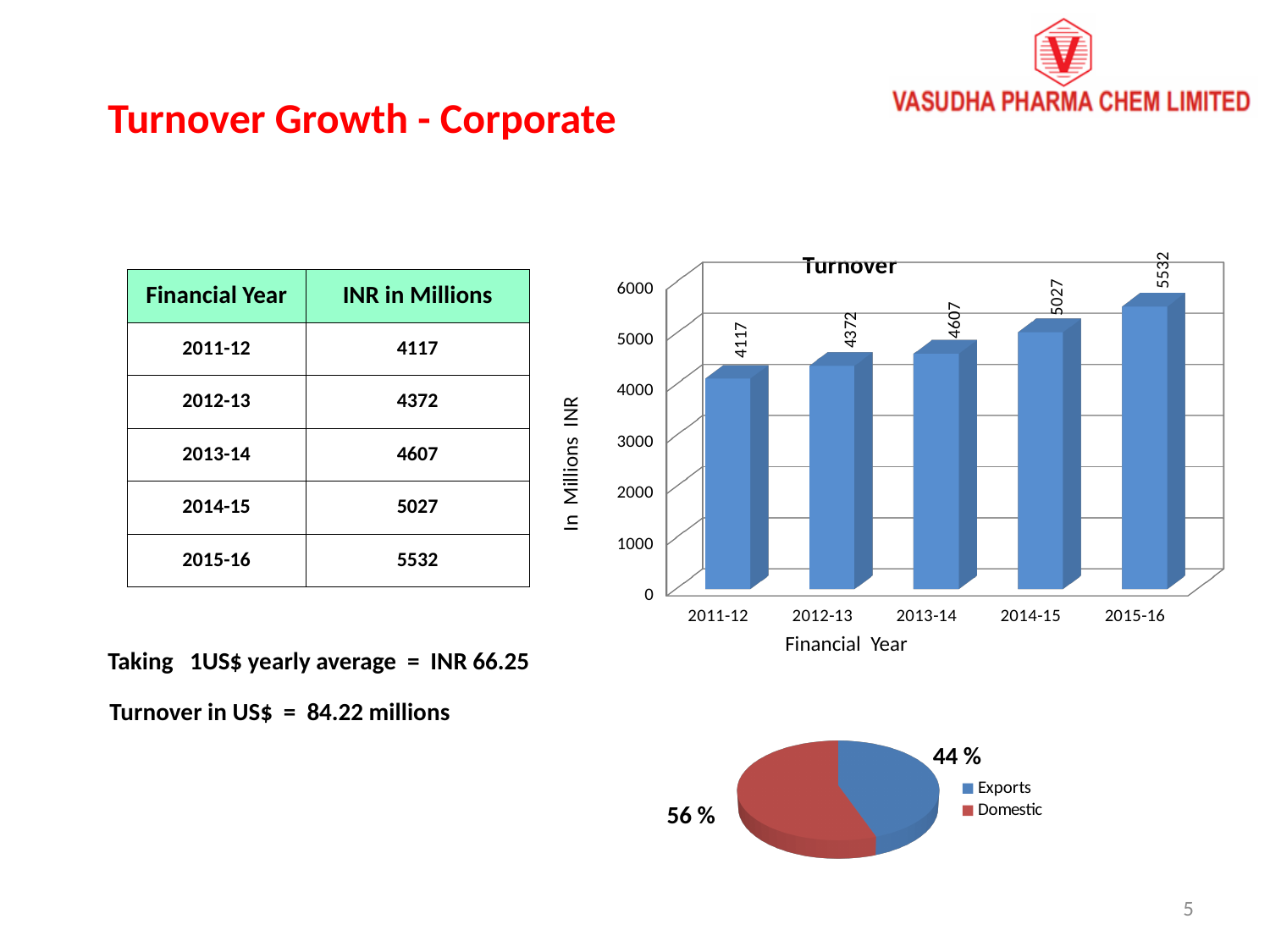
In the Turnover bar chart, what is the turnover for 2013-14? 4607 In the Turnover bar chart, what is the turnover for 2015-16? 5532 In the Turnover bar chart, which financial year has the lowest turnover? 2011-12 How many entries does the legend of the pie chart at the bottom right list? 2 In the pie chart at the bottom right, what share does Exports have? 44 % What kind of chart is the Turnover chart? Bar chart In the Turnover bar chart, which is larger, the turnover for 2012-13 or 2013-14? 2013-14 In the Turnover bar chart, do the values rise or fall from 2011-12 to 2015-16? Rise In the Turnover bar chart, how many financial years are shown? 5 In the pie chart at the bottom right, what share does Domestic have? 56 % In the Turnover bar chart, what is the difference between the turnover for 2015-16 and 2014-15? 505 In the Turnover bar chart, which financial year has the highest turnover? 2015-16